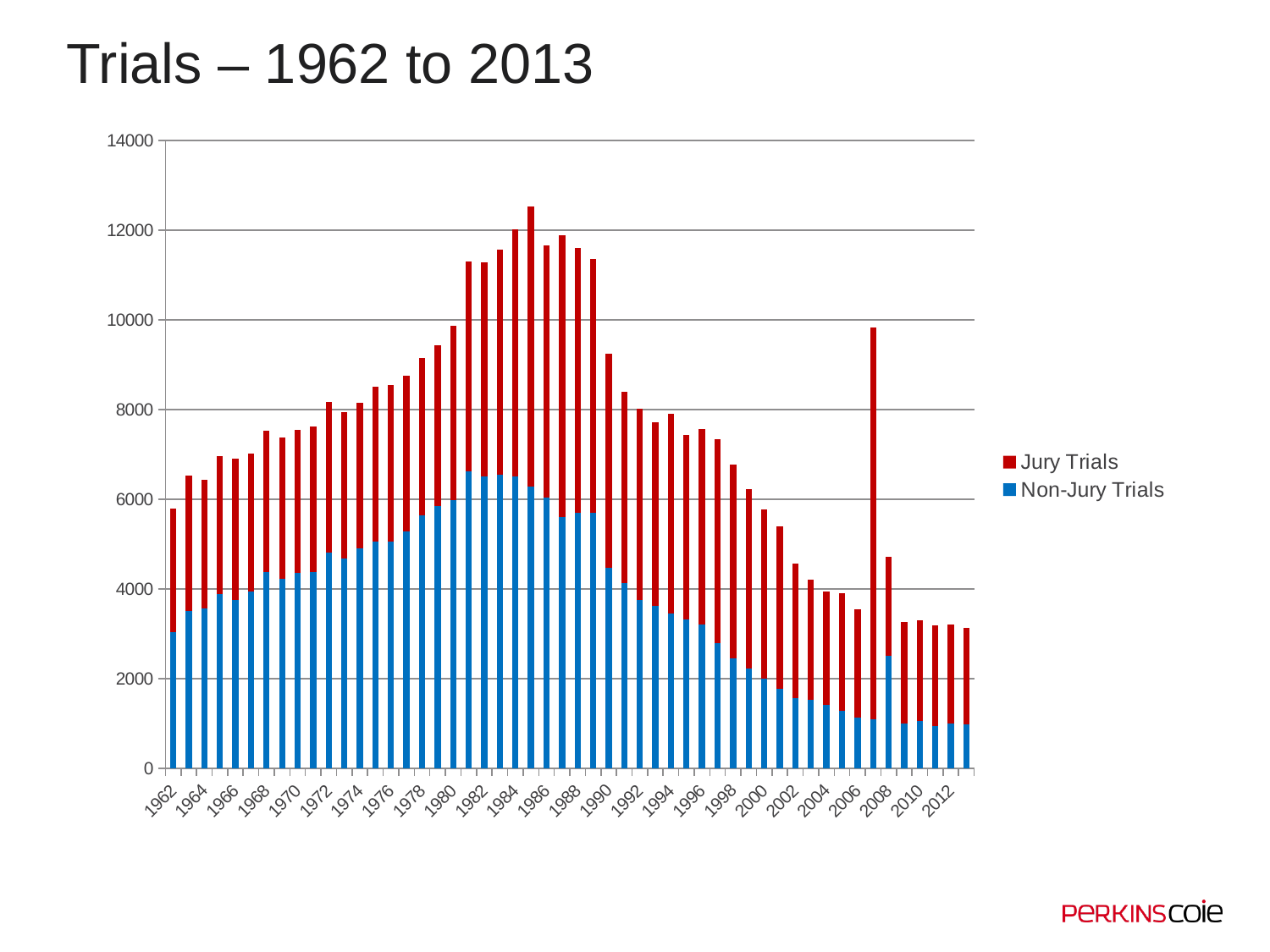
Is the total number of trials in 1982 greater or less than 10000? greater Do total trials generally rise or fall from 1990 to 2006? fall Which year has the larger total number of trials, 2002 or 2012? 2002 Is the total number of trials in 2000 greater or less than 6000? less Which year has more Non-Jury Trials, 1982 or 2012? 1982 How many years (bars) are plotted in the chart? 52 Is the total number of trials in 2010 greater or less than 2000? greater What is the title of the chart? Trials – 1962 to 2013 Which colour represents Jury Trials in the chart? red What kind of chart is shown on the slide? stacked bar chart How many series does the legend list? 2